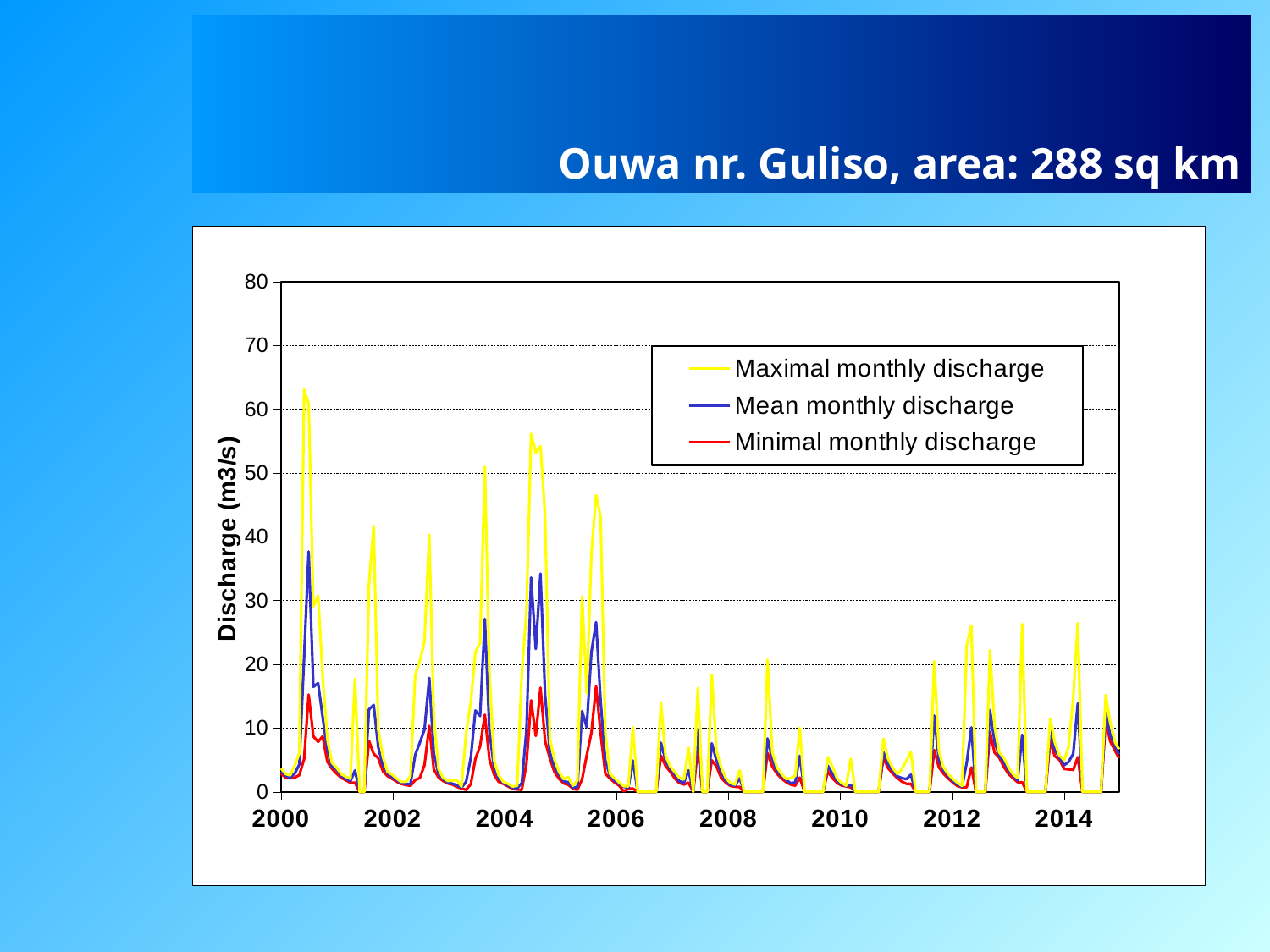
How many series does the legend list? 3 What is the label of the vertical axis? Discharge (m3/s) Which colour is used for the Maximal monthly discharge series? yellow Which series stays lowest on the chart? Minimal monthly discharge Is the peak of the Mean monthly discharge series around 2000 greater or less than 30? greater Around which year does the Maximal monthly discharge series reach its highest peak? 2000 What kind of chart is shown on the slide? line chart Do the peaks of the Maximal monthly discharge series generally rise or fall from 2000 to 2014? fall Is the highest peak of the Maximal monthly discharge series, around 2000, greater or less than 60? greater Which series reaches the highest values on the chart? Maximal monthly discharge Is the peak of the Minimal monthly discharge series around 2000 greater or less than 20? less